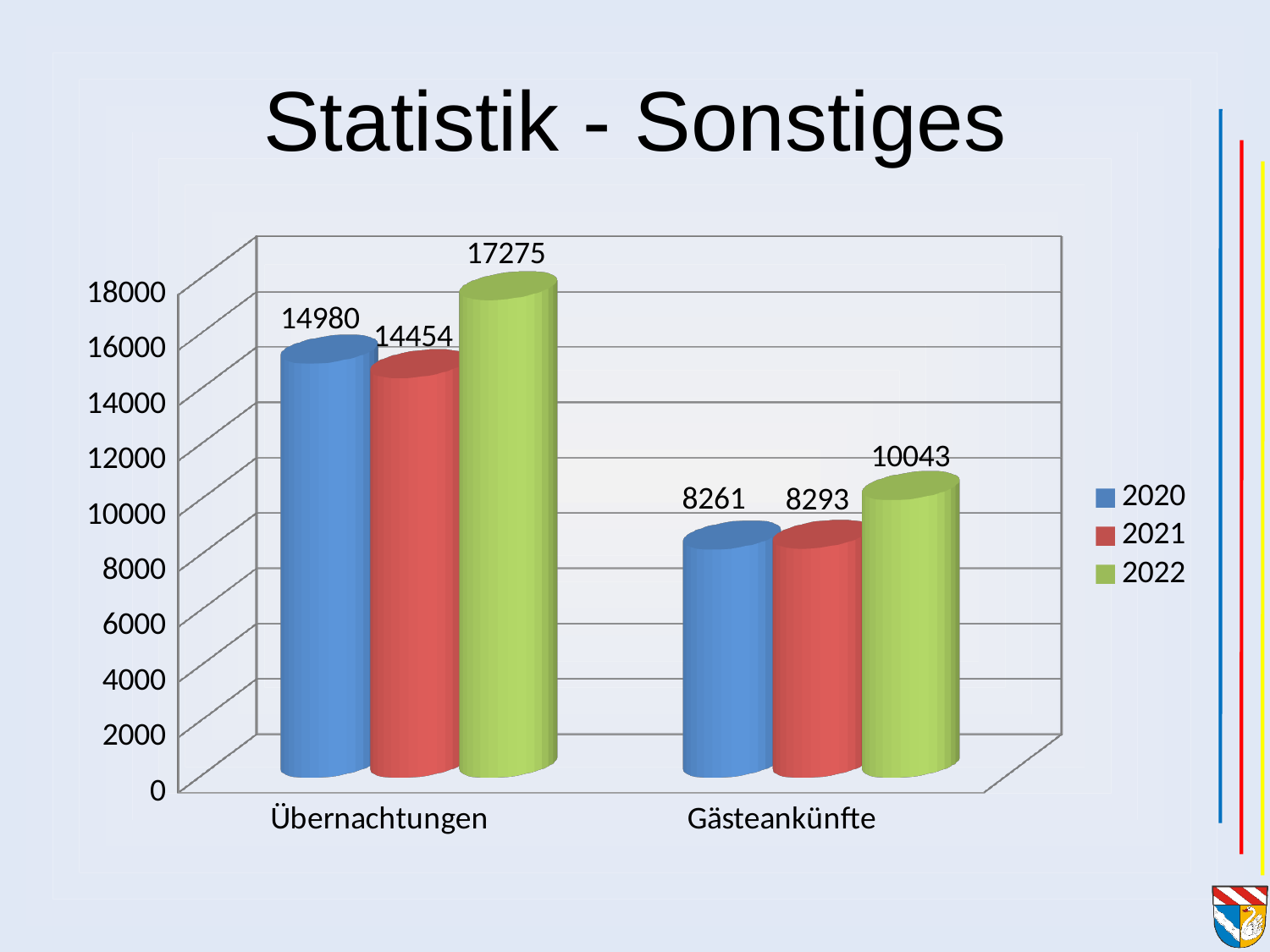
What is the value for Übernachtungen in 2021? 14454 What is the difference between the 2022 and 2020 values for Übernachtungen? 2295 How many categories are shown on the x axis? 2 What is the difference between the 2022 and 2021 values for Gästeankünfte? 1750 Which is larger: Übernachtungen in 2020 or Übernachtungen in 2021? Übernachtungen in 2020 Which year has the lowest value for Übernachtungen? 2021 How many series does the legend list? 3 What is the value for Gästeankünfte in 2020? 8261 What is the value for Übernachtungen in 2022? 17275 What kind of chart is shown on the slide? Bar chart Which year has the highest value for Übernachtungen? 2022 What is the value for Gästeankünfte in 2022? 10043